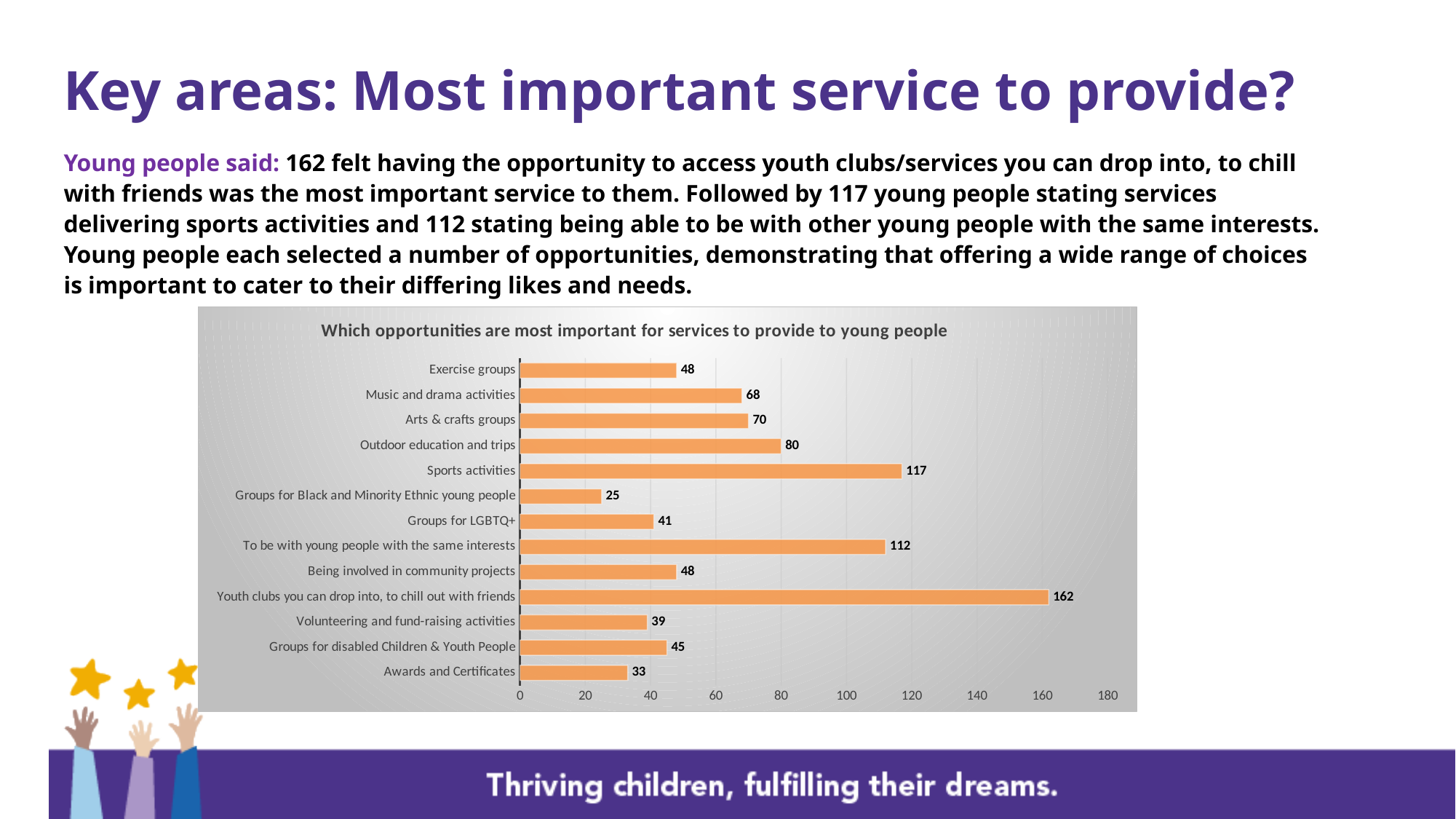
What is the value for Groups for LGBTQ+? 41 Which category has the lowest value? Groups for Black and Minority Ethnic young people What is the difference between the values for Youth clubs you can drop into, to chill out with friends and Sports activities? 45 What is the title of the chart? Which opportunities are most important for services to provide to young people Which category has the highest value? Youth clubs you can drop into, to chill out with friends What kind of chart is shown on the slide? Bar chart How many categories are shown in the chart? 13 What is the difference between the values for Outdoor education and trips and Arts & crafts groups? 10 What is the value for Sports activities? 117 Is the value for To be with young people with the same interests greater or less than 100? greater Which is larger: the value for Music and drama activities or the value for Groups for disabled Children & Youth People? Music and drama activities What is the value for Awards and Certificates? 33